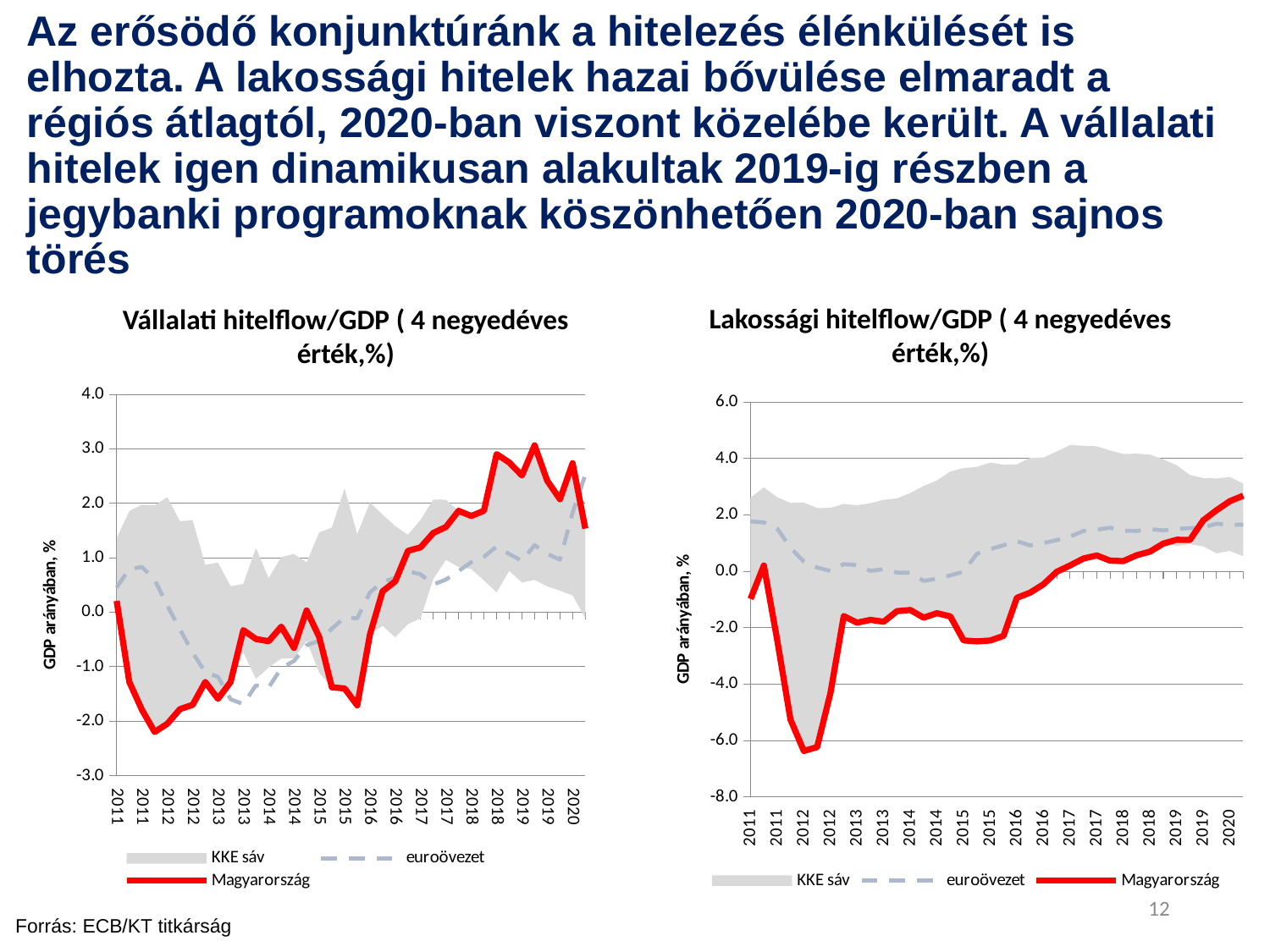
In the right chart 'Lakossági hitelflow/GDP', is the lowest value of the Magyarország line (around 2012) greater or less than -6.0? less In the right chart 'Lakossági hitelflow/GDP', is the euroövezet value at the end of 2020 greater or less than 2.0? less How many series does the legend of the right chart 'Lakossági hitelflow/GDP' list? 3 In the left chart 'Vállalati hitelflow/GDP', which series is drawn as a solid red line? Magyarország What is the y-axis label of the right chart 'Lakossági hitelflow/GDP'? GDP arányában, % What kind of chart is the left chart titled 'Vállalati hitelflow/GDP'? combination area and line chart In the left chart 'Vállalati hitelflow/GDP', which series is higher at the end of 2020, Magyarország or euroövezet? euroövezet In the right chart 'Lakossági hitelflow/GDP', which series is higher at the end of 2020, Magyarország or euroövezet? Magyarország In the right chart 'Lakossági hitelflow/GDP', does the Magyarország line generally rise or fall from 2013 to 2020? rise In the left chart 'Vállalati hitelflow/GDP', is the highest value of the Magyarország line (in 2019) greater or less than 2.0? greater